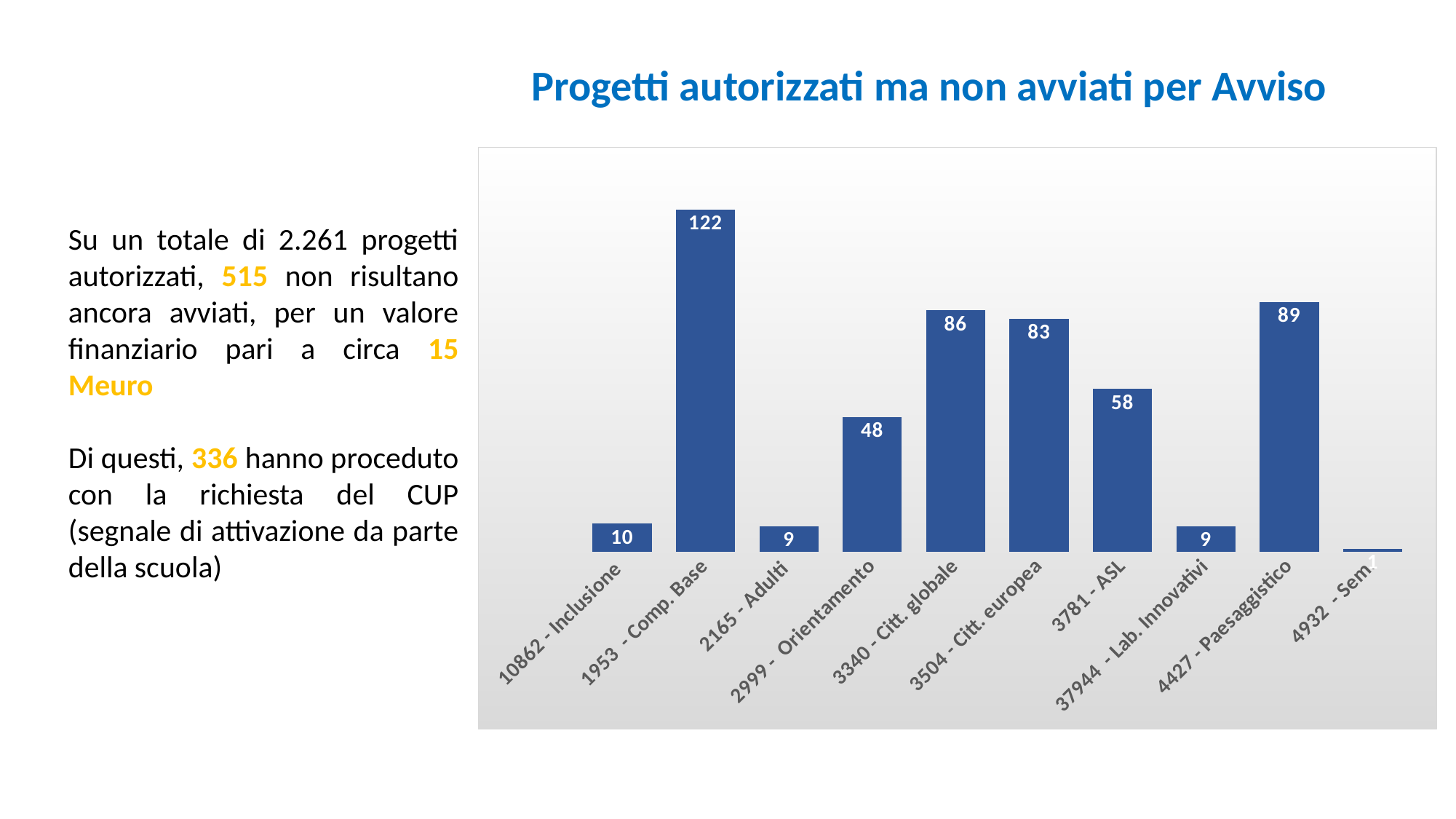
Which is larger, the value for 3340 - Citt. globale or the value for 3504 - Citt. europea? 3340 - Citt. globale What is the value for 3781 - ASL? 58 What is the title of the chart? Progetti autorizzati ma non avviati per Avviso What is the value for 2999 - Orientamento? 48 What is the difference between the values for 1953 - Comp. Base and 4427 - Paesaggistico? 33 Which category has the highest value? 1953 - Comp. Base What type of chart is shown on the slide? bar chart What is the value for 4427 - Paesaggistico? 89 Which category has the lowest value? 4932 - Sem. What is the difference between the values for 10862 - Inclusione and 2165 - Adulti? 1 What is the value for 1953 - Comp. Base? 122 How many categories (Avvisi) are shown in the chart? 10